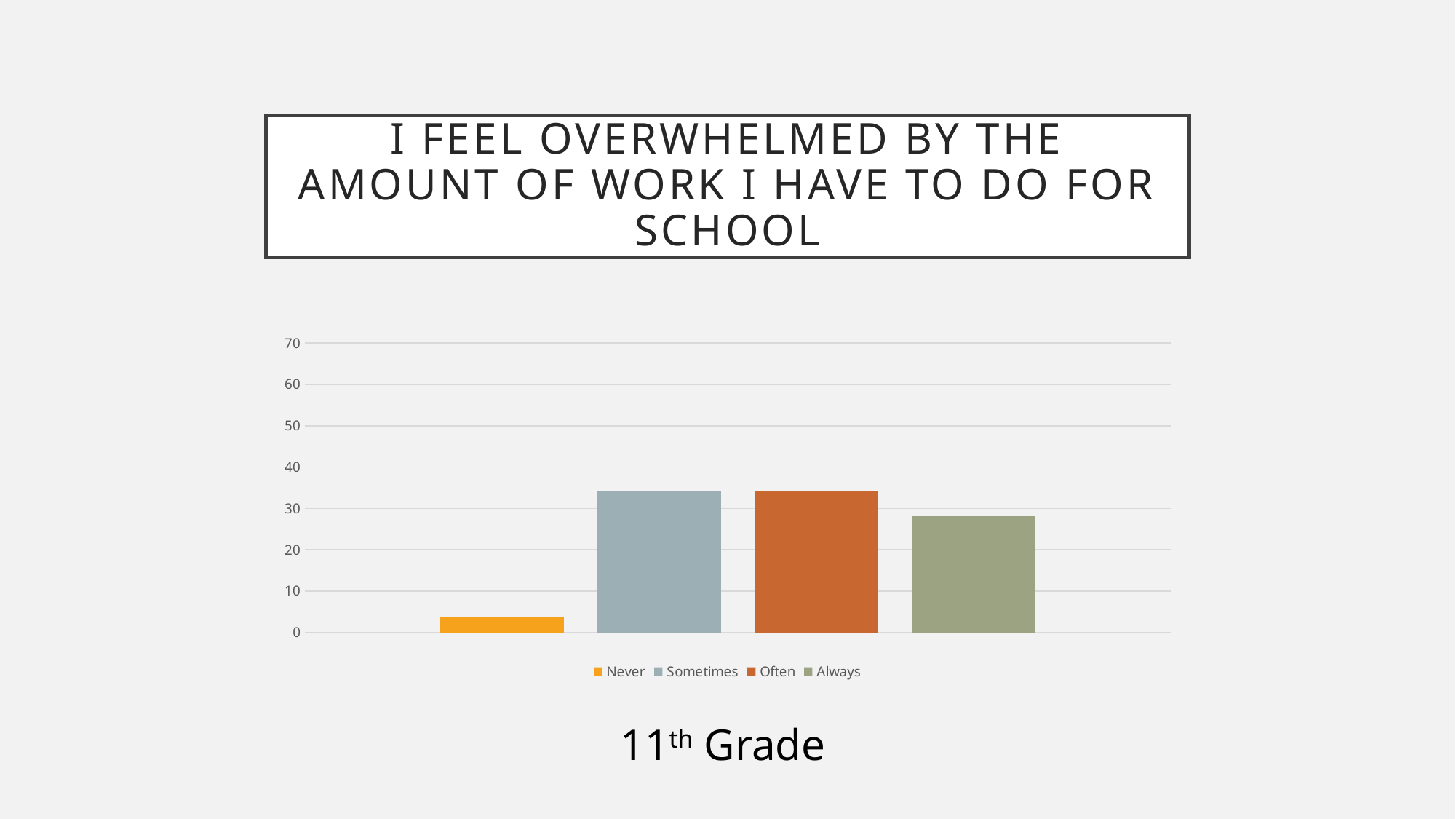
How many bars are plotted in the chart? 4 Which is larger, the value for Sometimes or the value for Always? Sometimes Which legend entry is shown in orange-brown (the third colour in the legend)? Often Is the value for Often greater or less than 30? greater What kind of chart is shown on the slide? bar chart Which is larger, the value for Always or the value for Never? Always Is the value for Always greater or less than 20? greater Is the value for Never greater or less than 10? less Which response has the lowest bar? Never How many series does the legend list? 4